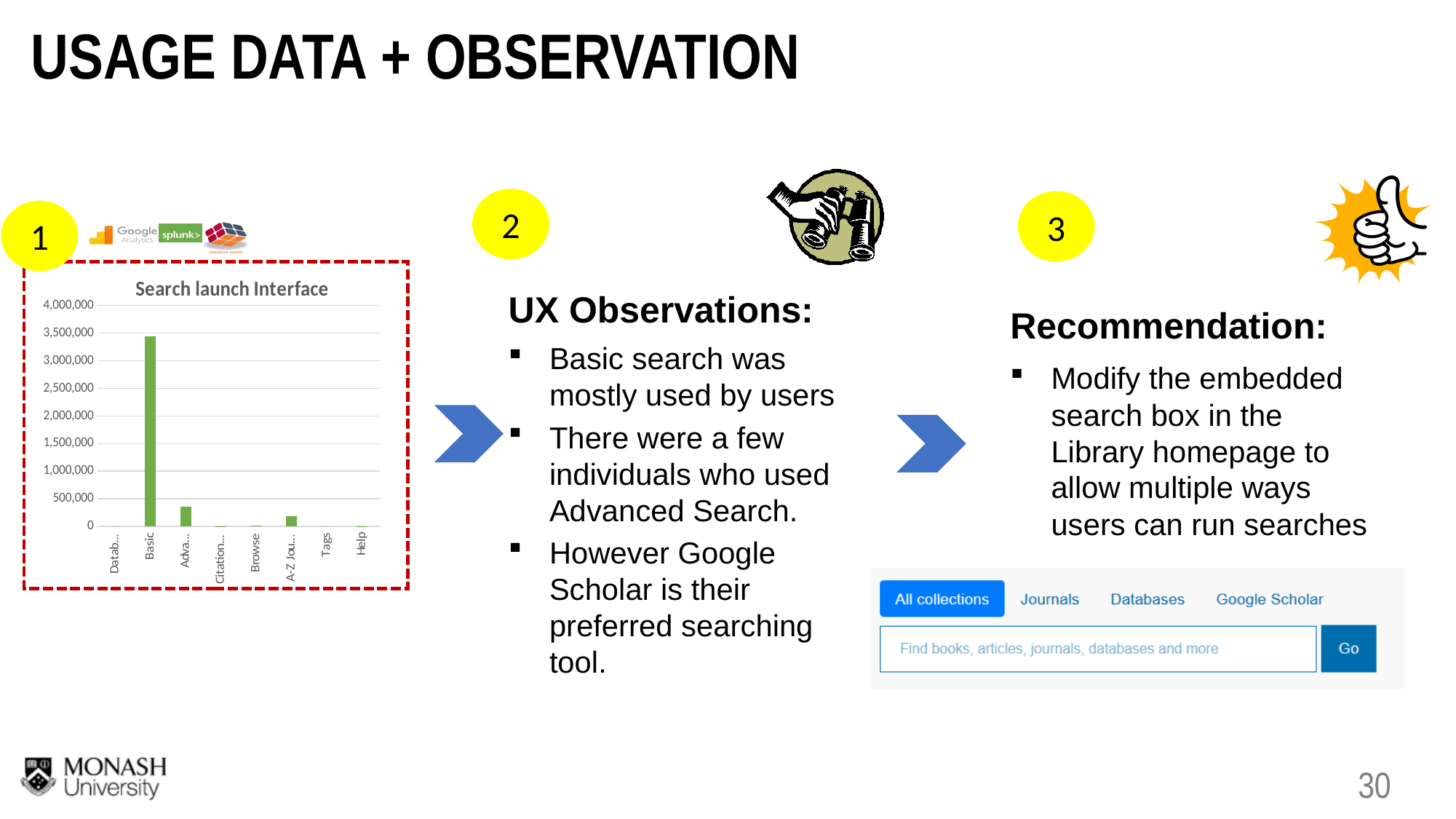
Which category has the highest value in the Search launch Interface chart? Basic Is the value for Adva... greater or less than 500,000? less Is the value for A-Z Jou... greater or less than 500,000? less What is the highest tick value shown on the y axis of the Search launch Interface chart? 4,000,000 How many categories are shown on the x axis of the Search launch Interface chart? 8 Which is larger in the Search launch Interface chart, Adva... or A-Z Jou...? Adva... What kind of chart is shown on the slide? bar chart Is the value for Basic greater or less than 4,000,000? less Which is larger in the Search launch Interface chart, Basic or Adva...? Basic What is the title of the chart on the slide? Search launch Interface